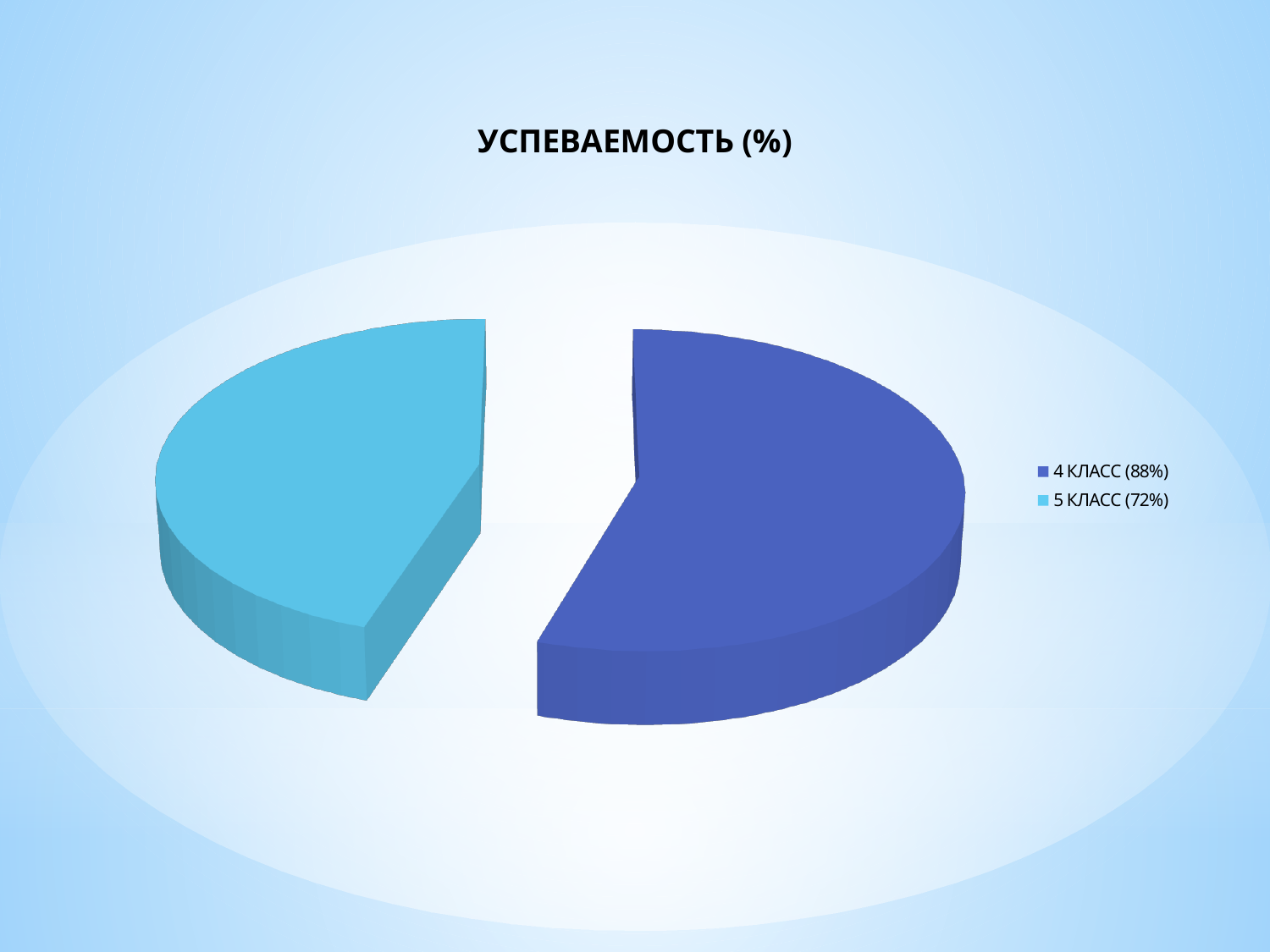
What value is shown for 4 КЛАСС in the legend? 88% Is the value for 5 КЛАСС greater or less than 80? less What is the difference between the values for 4 КЛАСС and 5 КЛАСС? 16% What is the title of the chart? УСПЕВАЕМОСТЬ (%) Is the value for 4 КЛАСС larger or smaller than the value for 5 КЛАСС? Larger How many slices does the pie chart have? 2 What value is shown for 5 КЛАСС in the legend? 72% Which colour represents 4 КЛАСС in the chart? Dark blue Which class has the higher value? 4 КЛАСС What kind of chart is shown on the slide? Pie chart Which class has the lower value? 5 КЛАСС